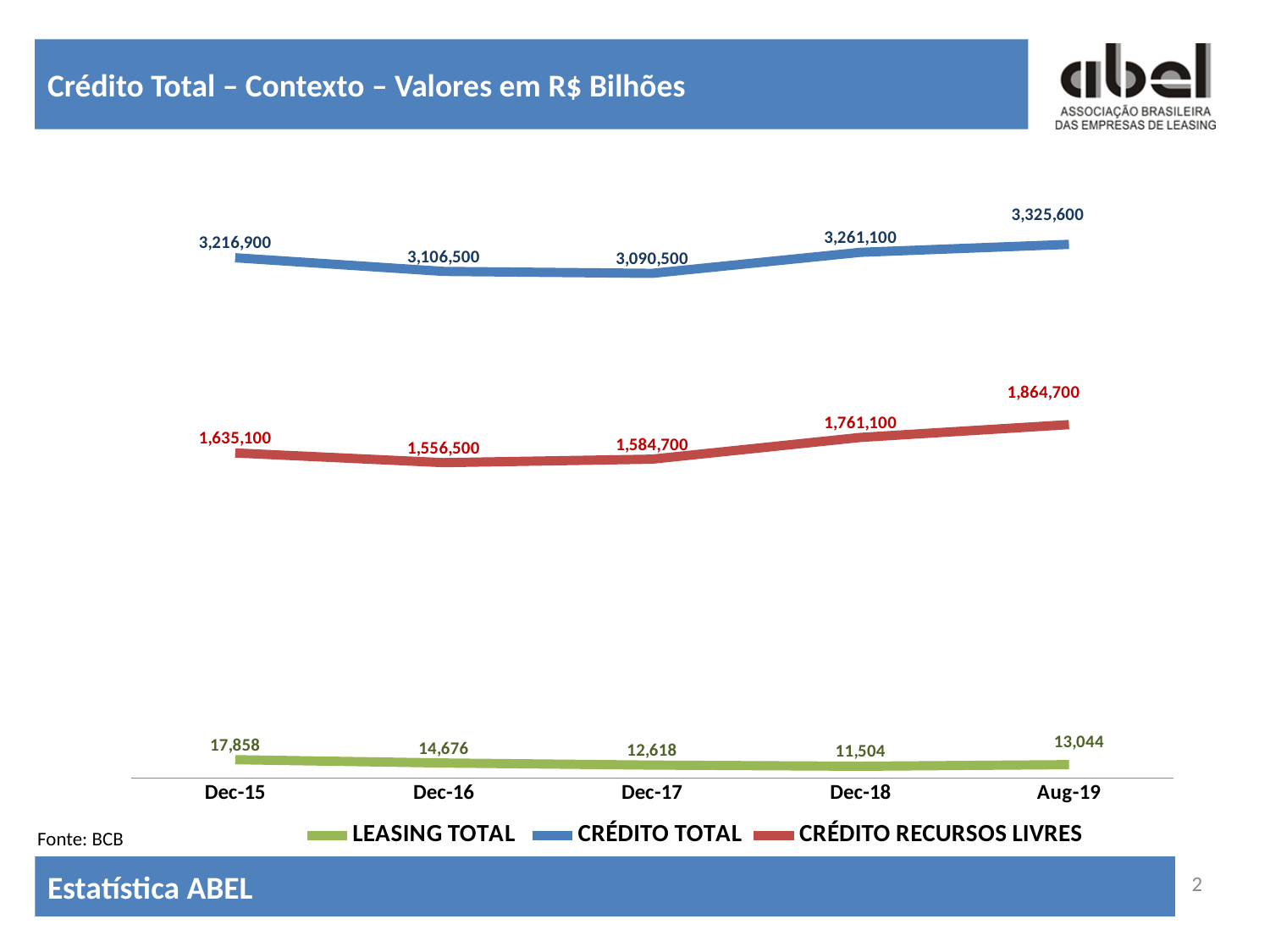
What kind of chart is shown on the slide? Line chart How many periods are shown on the x axis? 5 Which is larger: CRÉDITO RECURSOS LIVRES at Dec-16 or at Dec-17? Dec-17 At which period is LEASING TOTAL lowest? Dec-18 What is the value of LEASING TOTAL at Dec-17? 12,618 What is the difference between the CRÉDITO TOTAL values at Aug-19 and Dec-15? 108,700 What is the value of CRÉDITO RECURSOS LIVRES at Aug-19? 1,864,700 At which period is LEASING TOTAL highest? Dec-15 What is the value of CRÉDITO TOTAL at Dec-15? 3,216,900 How many series does the legend list? 3 At which period is CRÉDITO TOTAL lowest? Dec-17 What is the difference between the LEASING TOTAL values at Dec-15 and Dec-18? 6,354